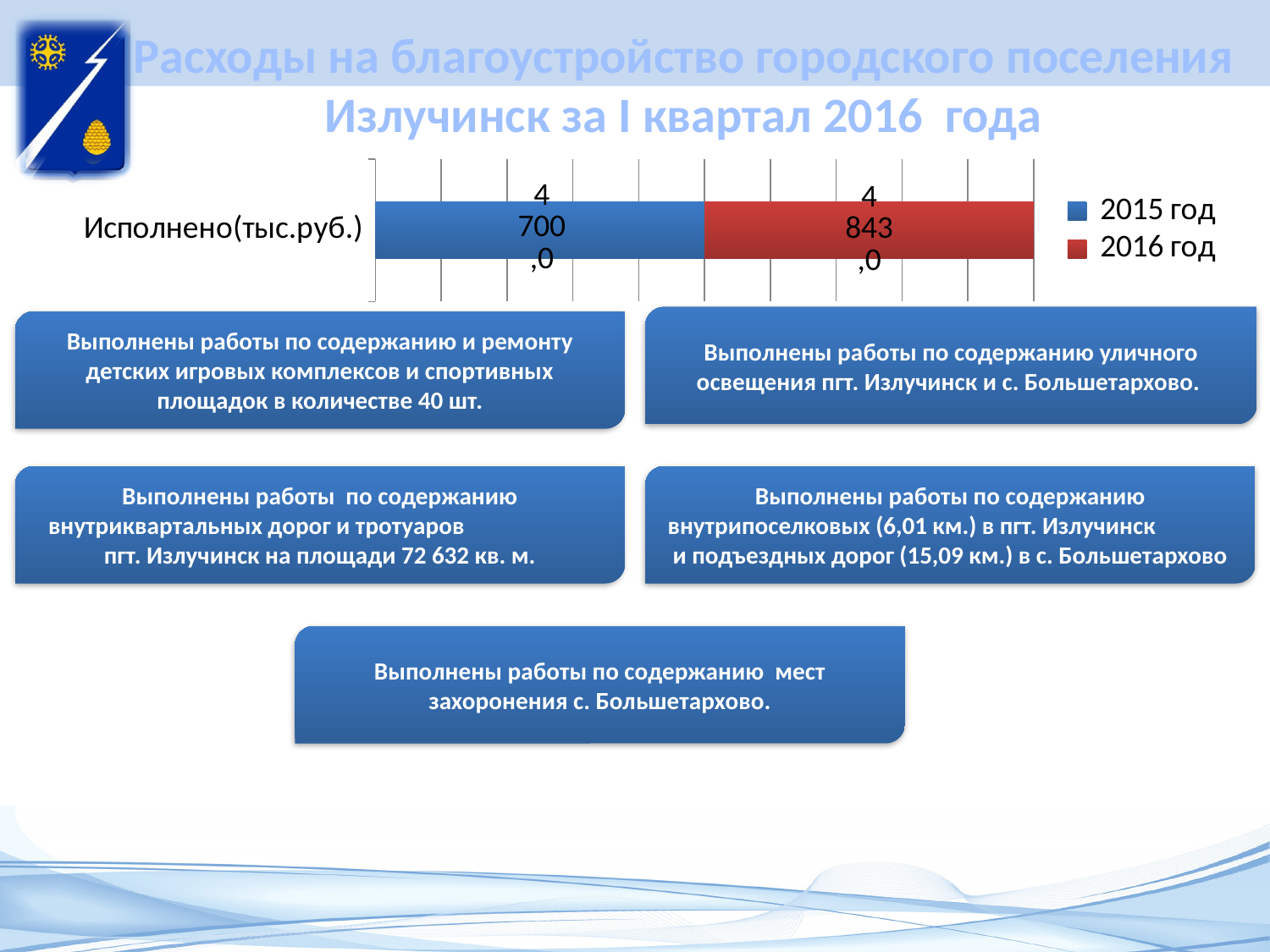
Which colour represents 2016 год in the chart? Red What is the total of the stacked bar for Исполнено(тыс.руб.)? 9 543,0 What is the value for 2016 год in the chart? 4 843,0 How many series does the legend list? 2 What is the value for 2015 год in the chart? 4 700,0 What is the difference between the 2016 год value and the 2015 год value? 143,0 What kind of chart is shown on the slide? Bar chart Which series has the larger value, 2015 год or 2016 год? 2016 год How many categories are shown on the chart's category axis? 1 What is the label of the category shown on the chart? Исполнено(тыс.руб.)